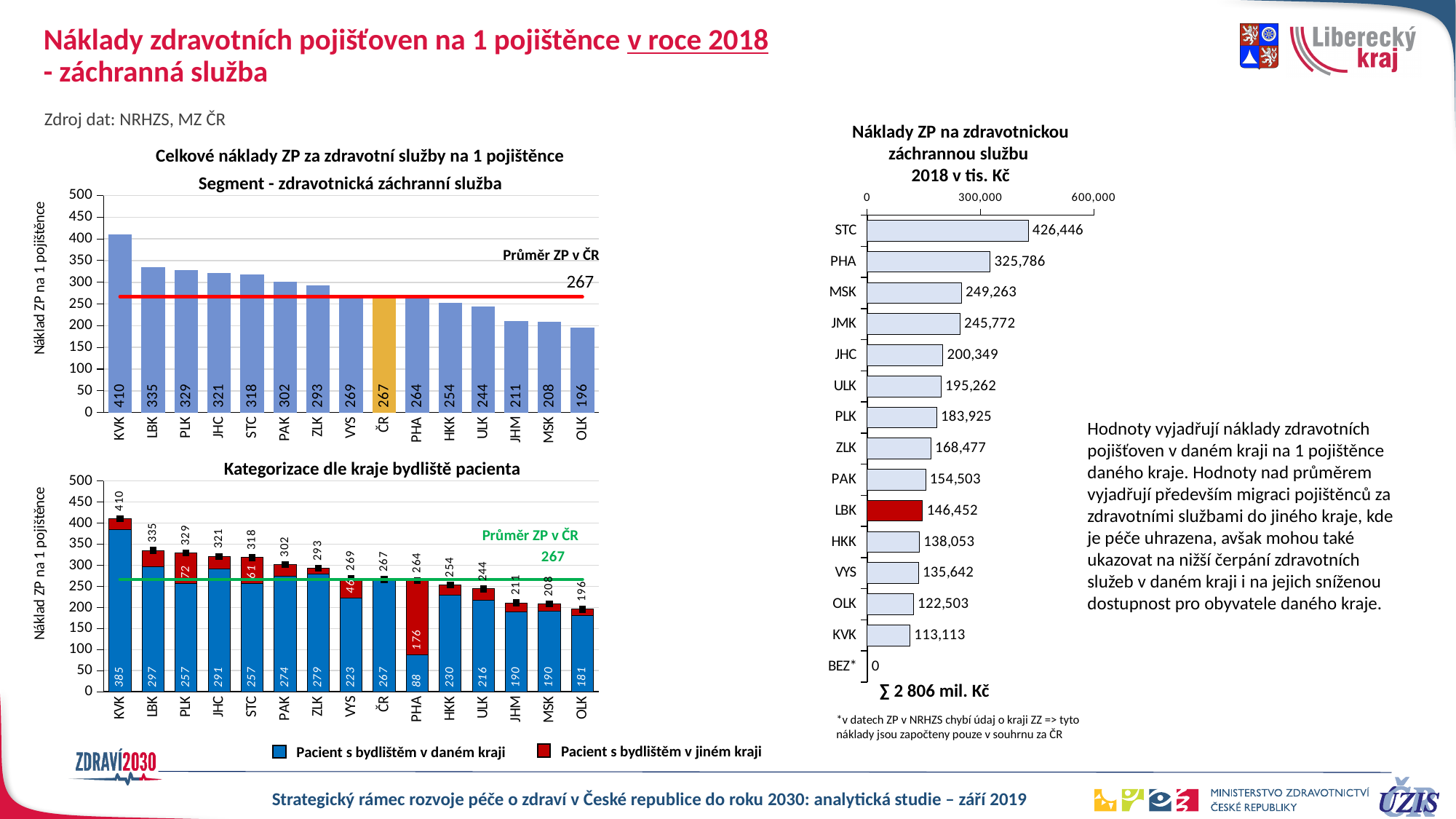
In the bottom-left chart 'Kategorizace dle kraje bydliště pacienta', which is larger: the 'Pacient s bydlištěm v daném kraji' value for KVK or for LBK? KVK In the top-left chart 'Celkové náklady ZP za zdravotní služby na 1 pojištěnce', which category has the lowest value? OLK In the top-left chart 'Celkové náklady ZP za zdravotní služby na 1 pojištěnce', what value is shown for the 'Průměr ZP v ČR' line? 267 In the right chart 'Náklady ZP na zdravotnickou záchrannou službu 2018 v tis. Kč', what is the value for LBK? 146,452 In the bottom-left chart 'Kategorizace dle kraje bydliště pacienta', what is the value of the 'Pacient s bydlištěm v daném kraji' segment for PHA? 88 In the bottom-left chart 'Kategorizace dle kraje bydliště pacienta', what is the total of the stacked bar for PHA? 264 In the top-left chart 'Celkové náklady ZP za zdravotní služby na 1 pojištěnce', what is the value for KVK? 410 In the right chart 'Náklady ZP na zdravotnickou záchrannou službu 2018 v tis. Kč', which category has the highest value? STC In the right chart 'Náklady ZP na zdravotnickou záchrannou službu 2018 v tis. Kč', how many categories are shown? 15 In the bottom-left chart 'Kategorizace dle kraje bydliště pacienta', how many series does the legend list? 2 What type of chart is the right chart 'Náklady ZP na zdravotnickou záchrannou službu 2018 v tis. Kč'? Bar chart In the top-left chart 'Celkové náklady ZP za zdravotní služby na 1 pojištěnce', what is the difference between the values for LBK and ČR? 68